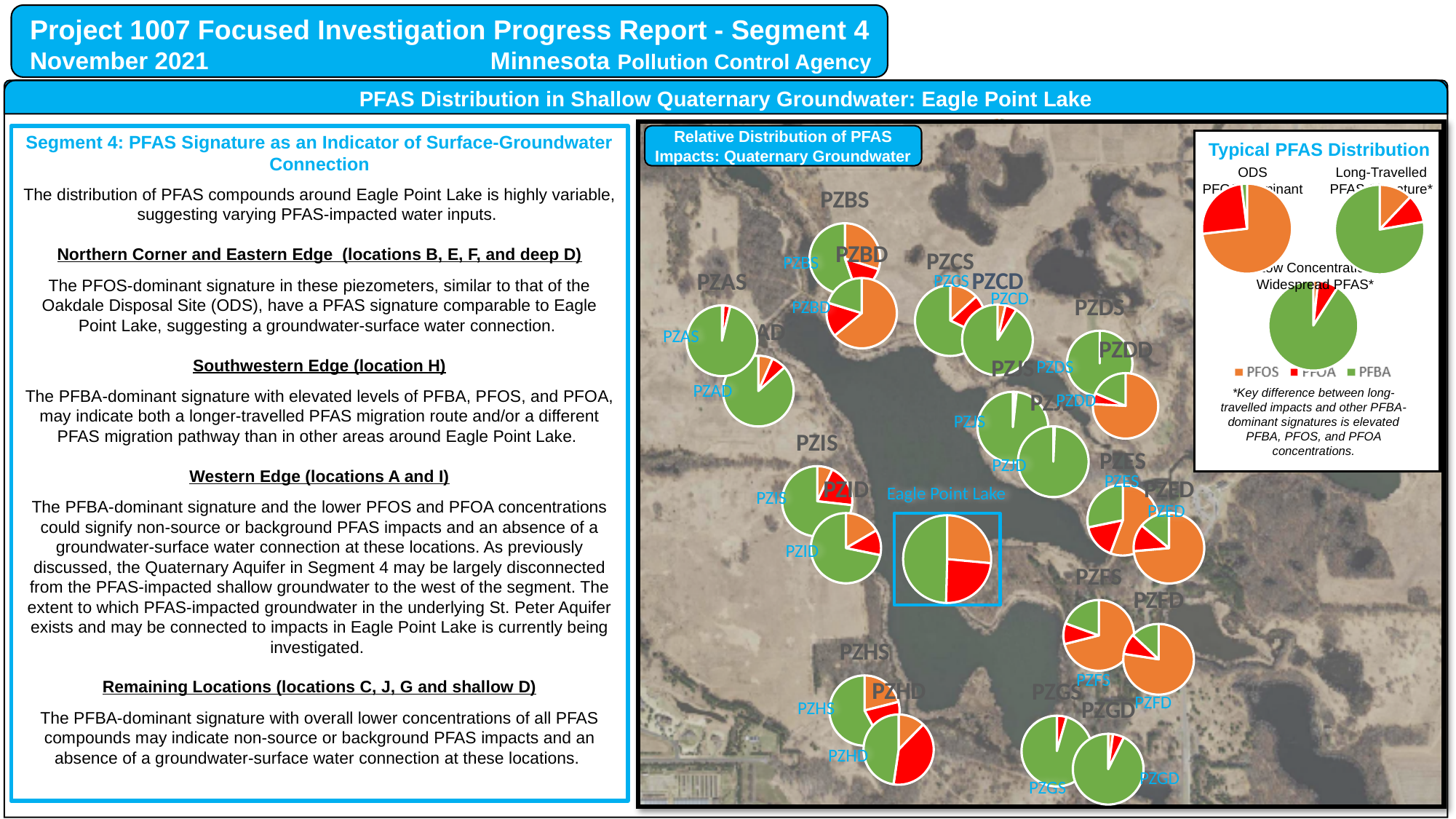
How many pie charts are shown in the Typical PFAS Distribution panel? 3 In the PZFD pie chart, which compound has the largest slice? PFOS How many compounds does the legend in the Typical PFAS Distribution panel list? 3 In the ODS PFOS-dominant pie chart of the Typical PFAS Distribution panel, which compound has the largest slice? PFOS In the PZED pie chart, is the PFOS slice or the PFBA slice larger? PFOS In the PZAS pie chart, which compound has the largest slice? PFBA Which three compounds are listed in the legend of the Typical PFAS Distribution panel? PFOS, PFOA, PFBA What kind of chart is used to show the PFAS distribution at each piezometer location on the map? Pie chart In the Typical PFAS Distribution panel, which colour represents PFBA? Green